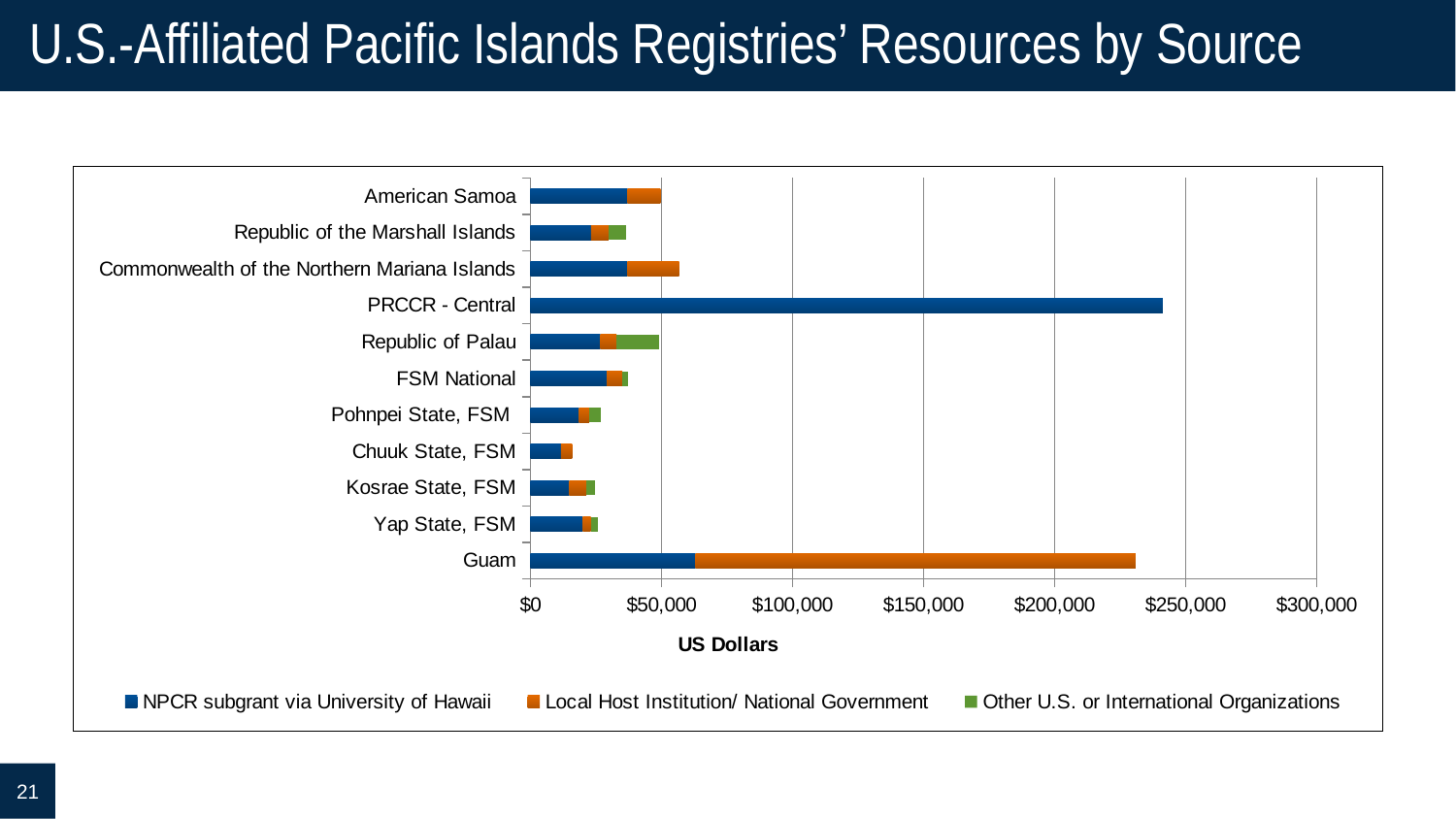
Which has a larger total bar, Guam or American Samoa? Guam Is the total value for American Samoa greater or less than $100,000? less Which registry has the largest Other U.S. or International Organizations segment? Republic of Palau Which registry has the smallest total bar? Chuuk State, FSM How many series does the legend list? 3 Which registry has the largest Local Host Institution/ National Government segment? Guam Which registry has the largest NPCR subgrant via University of Hawaii segment? PRCCR - Central What colour represents the NPCR subgrant via University of Hawaii series? Blue What is the title of the horizontal axis? US Dollars How many registries (categories) are plotted on the chart? 11 What kind of chart is shown on the slide? Stacked bar chart Is the total value for Guam greater or less than $200,000? greater